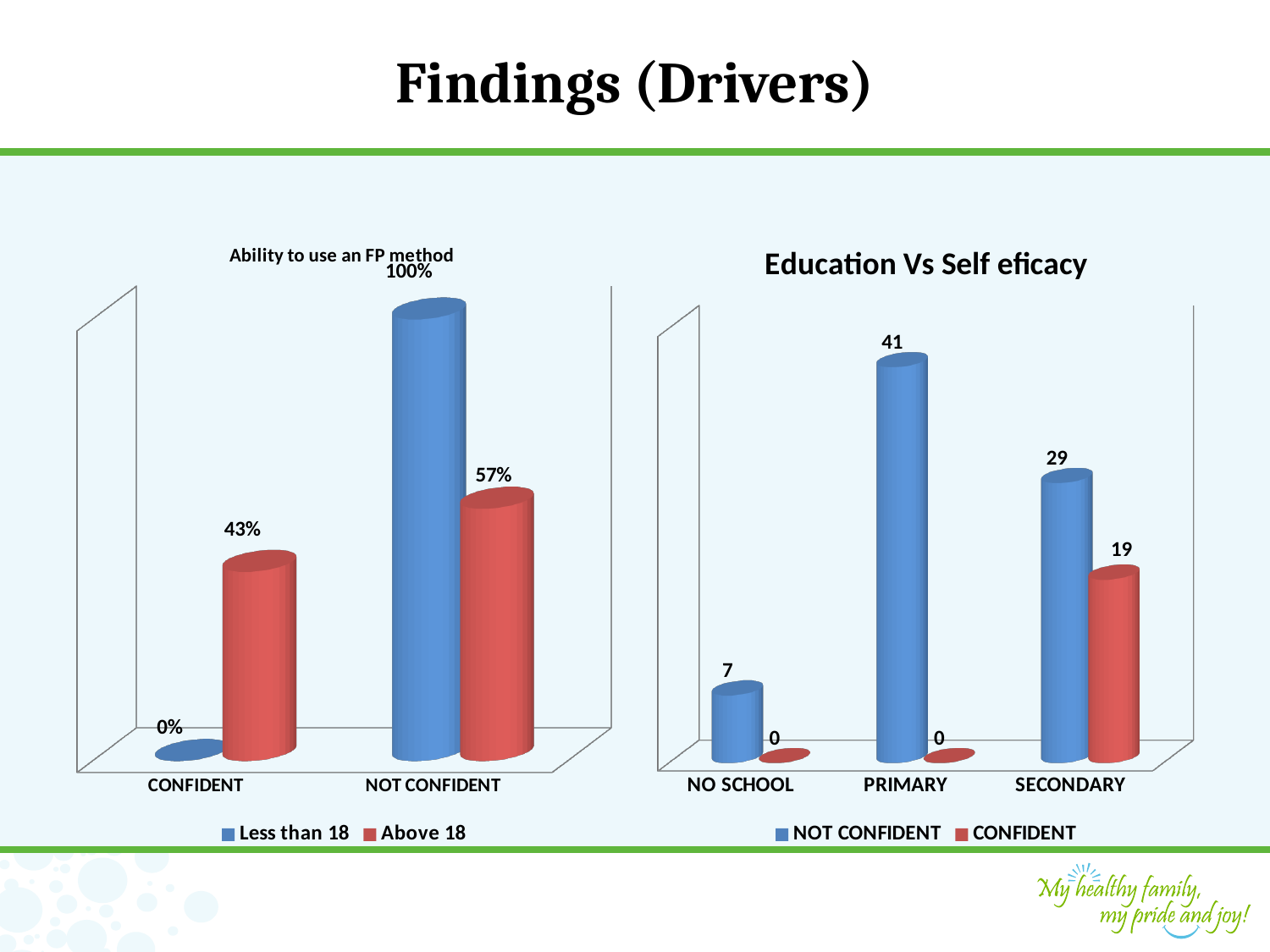
In the 'Education Vs Self eficacy' chart, how many education categories are shown on the x axis? 3 What kind of chart is the 'Education Vs Self eficacy' chart? Bar chart In the 'Ability to use an FP method' chart, what is the value for 'Above 18' in the CONFIDENT category? 43% In the 'Ability to use an FP method' chart, which series is shown in red? Above 18 In the 'Education Vs Self eficacy' chart, which education category has the highest NOT CONFIDENT value? PRIMARY In the 'Education Vs Self eficacy' chart, what is the CONFIDENT value for SECONDARY? 19 In the 'Education Vs Self eficacy' chart, what is the NOT CONFIDENT value for PRIMARY? 41 In the 'Ability to use an FP method' chart, what is the difference between the 'Above 18' values for NOT CONFIDENT and CONFIDENT? 14% In the 'Education Vs Self eficacy' chart, which education category has the lowest NOT CONFIDENT value? NO SCHOOL In the 'Ability to use an FP method' chart, how many series does the legend list? 2 In the 'Ability to use an FP method' chart, what is the value for 'Less than 18' in the NOT CONFIDENT category? 100% In the 'Education Vs Self eficacy' chart, what is the difference between the NOT CONFIDENT and CONFIDENT values for SECONDARY? 10